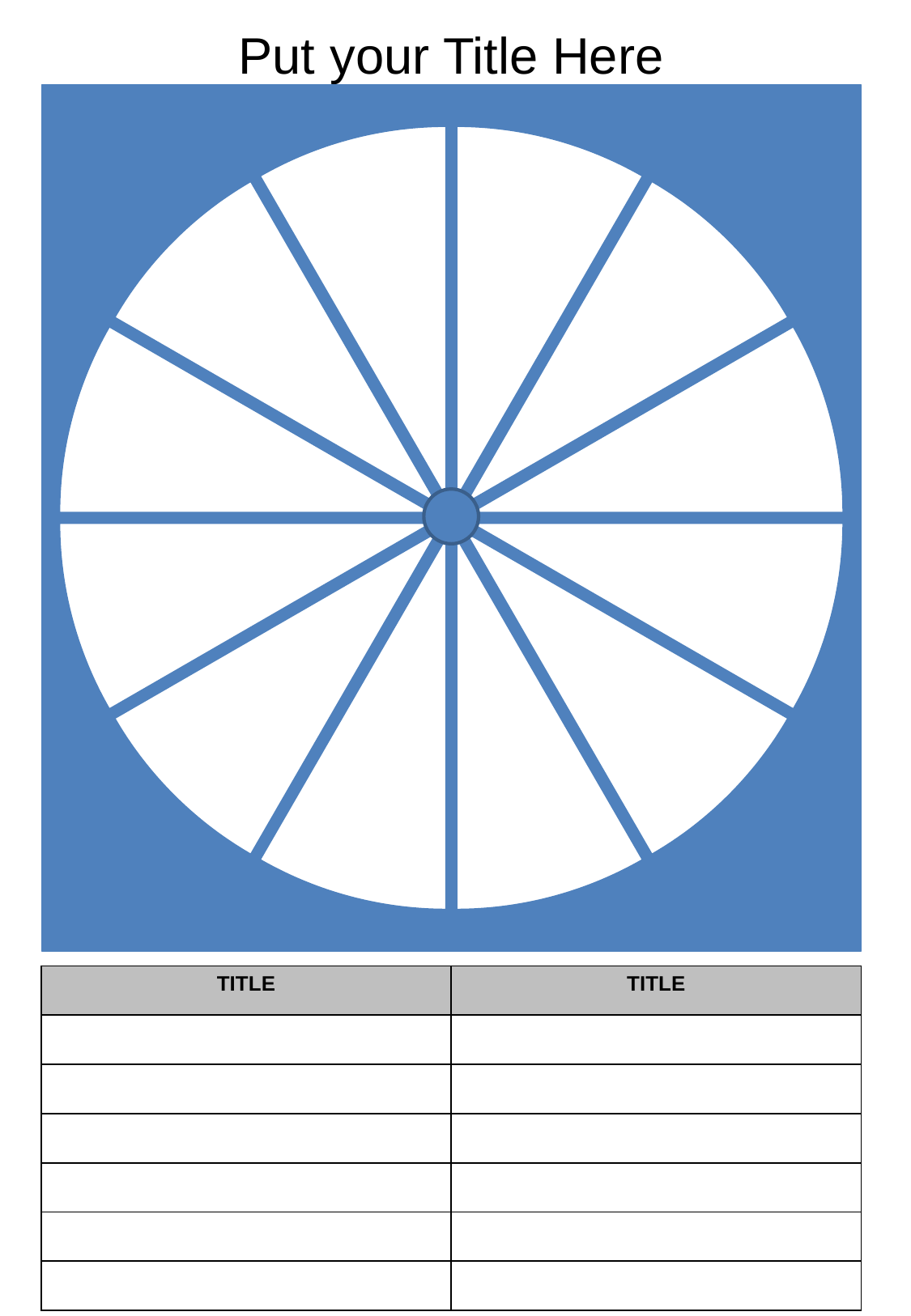
What colour is the background square behind the pie chart? blue What kind of chart is shown on the slide? pie chart How many slices does the pie chart have? 12 Are the slices of the pie chart all the same size? yes What is the title shown above the chart? Put your Title Here